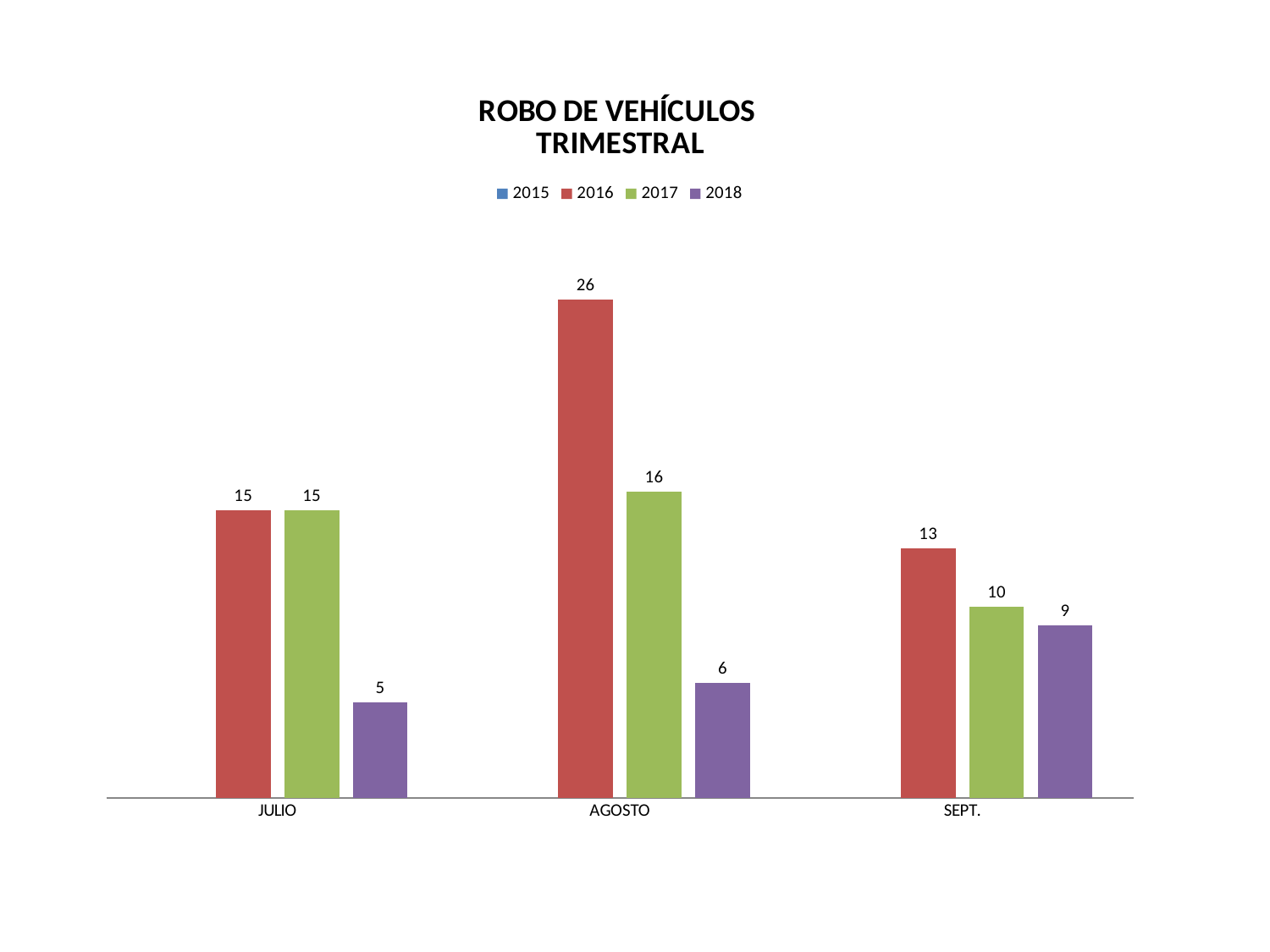
In which month is the 2016 value highest? AGOSTO What kind of chart is this? bar chart What is the title of the chart? ROBO DE VEHÍCULOS TRIMESTRAL What is the difference between the 2016 and 2017 values in AGOSTO? 10 Which is larger in SEPT., the 2016 value or the 2018 value? 2016 What is the value for 2018 in JULIO? 5 In which month is the 2018 value lowest? JULIO What is the value for 2016 in AGOSTO? 26 How many series does the legend list? 4 How many months are shown on the x axis? 3 What is the value for 2018 in SEPT.? 9 What is the value for 2017 in SEPT.? 10